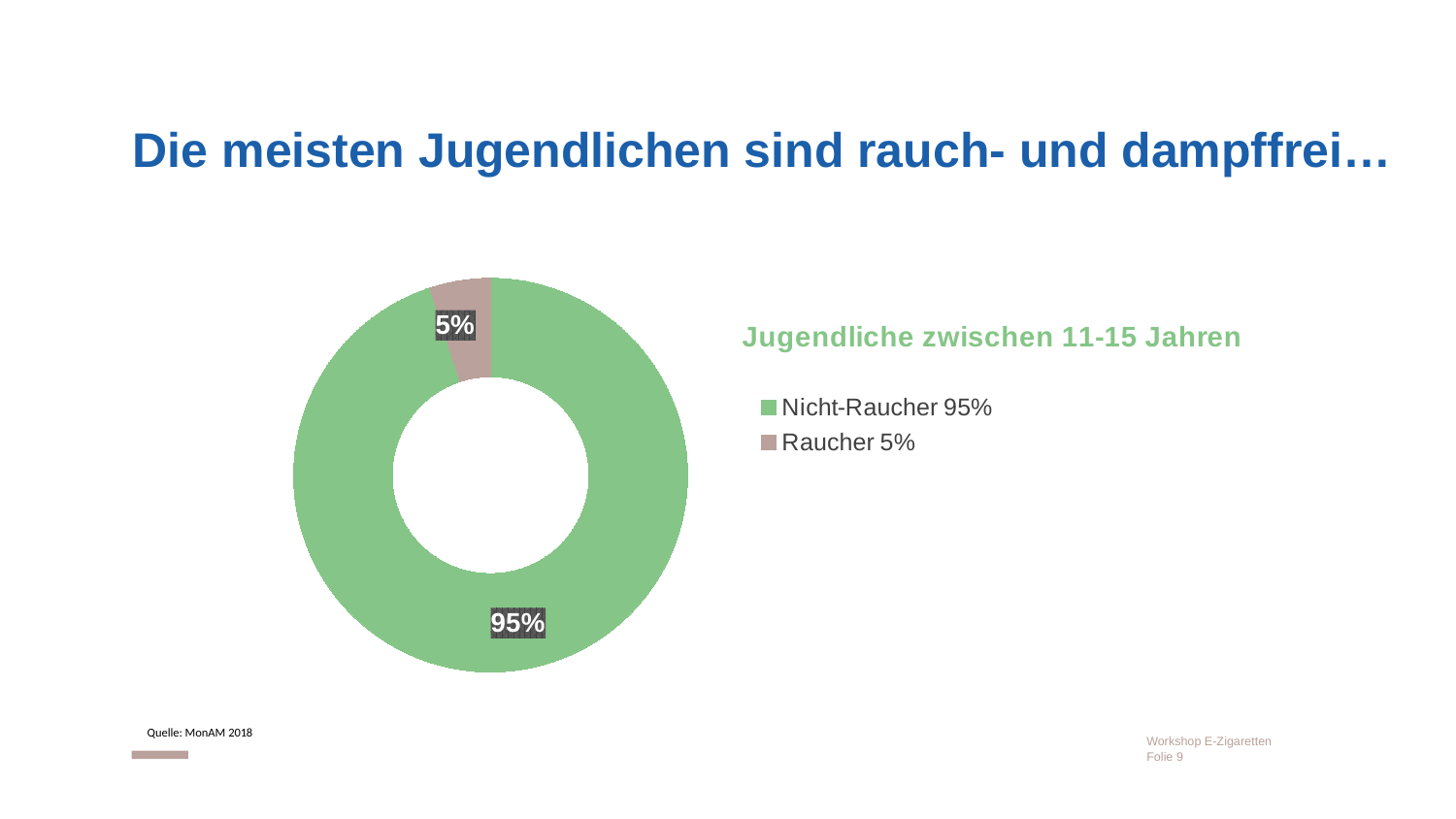
Which is larger, the share for Nicht-Raucher or the share for Raucher? Nicht-Raucher What colour is the Nicht-Raucher slice? Green What share of the chart is labelled Raucher? 5% How many categories does the chart show? 2 Which category has the smallest share of the chart? Raucher What is the total of the two shares shown in the chart? 100% Which category has the largest share of the chart? Nicht-Raucher How many entries does the legend list? 2 What kind of chart is shown on the slide? Doughnut (pie) chart What share of the chart is labelled Nicht-Raucher? 95% What is the title of the chart? Jugendliche zwischen 11-15 Jahren What is the difference in percentage points between the Nicht-Raucher and Raucher shares? 90 percentage points